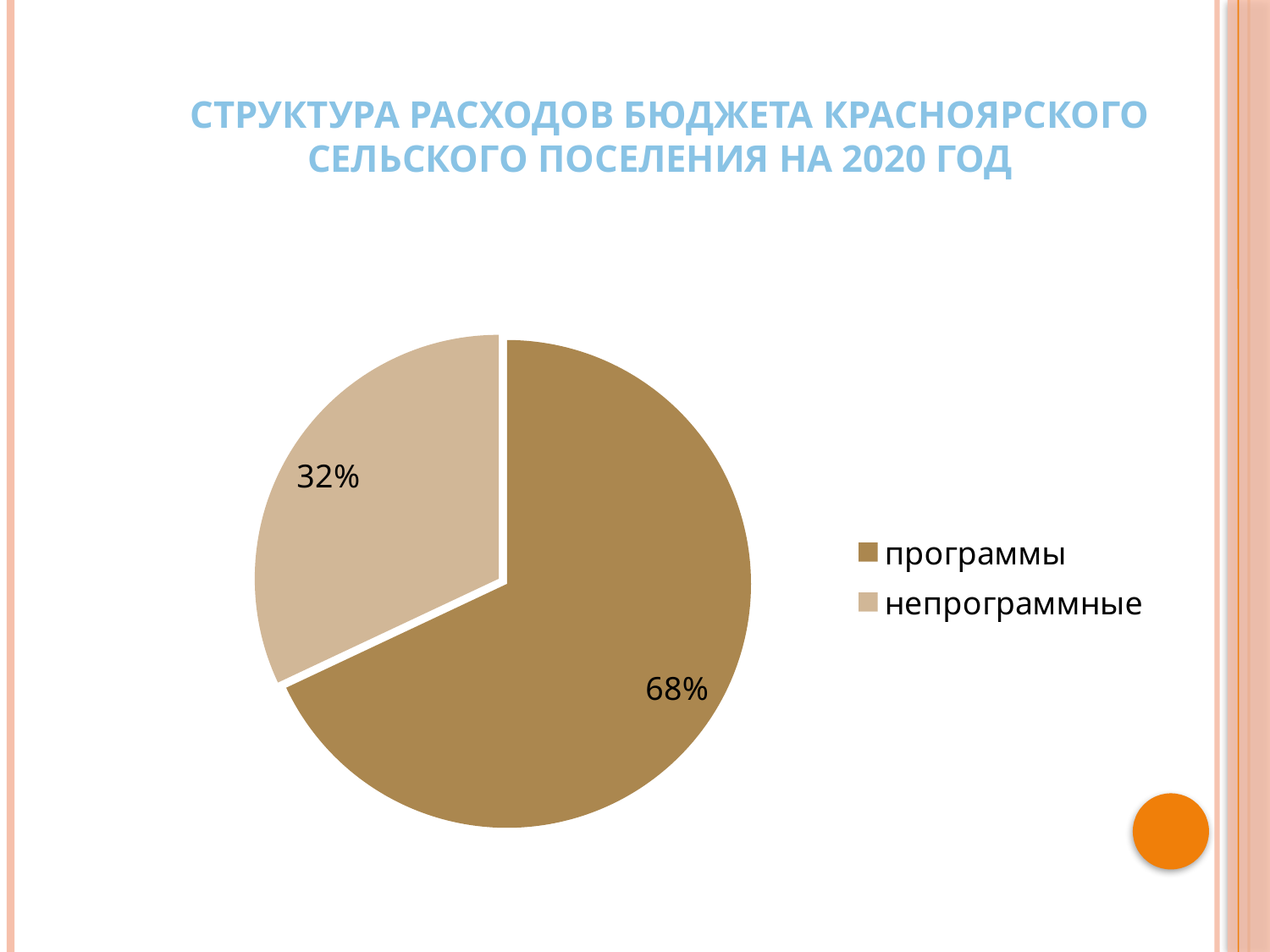
Which legend entry is shown in the lighter beige colour? непрограммные What share of the pie does the "непрограммные" slice represent? 32% What is the difference in percentage points between the "программы" and "непрограммные" slices? 36 What is the title of the slide containing the chart? Структура расходов бюджета Красноярского сельского поселения на 2020 год What type of chart is shown on the slide? pie chart What share of the pie does the "программы" slice represent? 68% Which is larger, the "программы" slice or the "непрограммные" slice? программы Which category has the smallest slice of the pie? непрограммные How many slices does the pie chart have? 2 Which category has the largest slice of the pie? программы How many entries does the legend list? 2